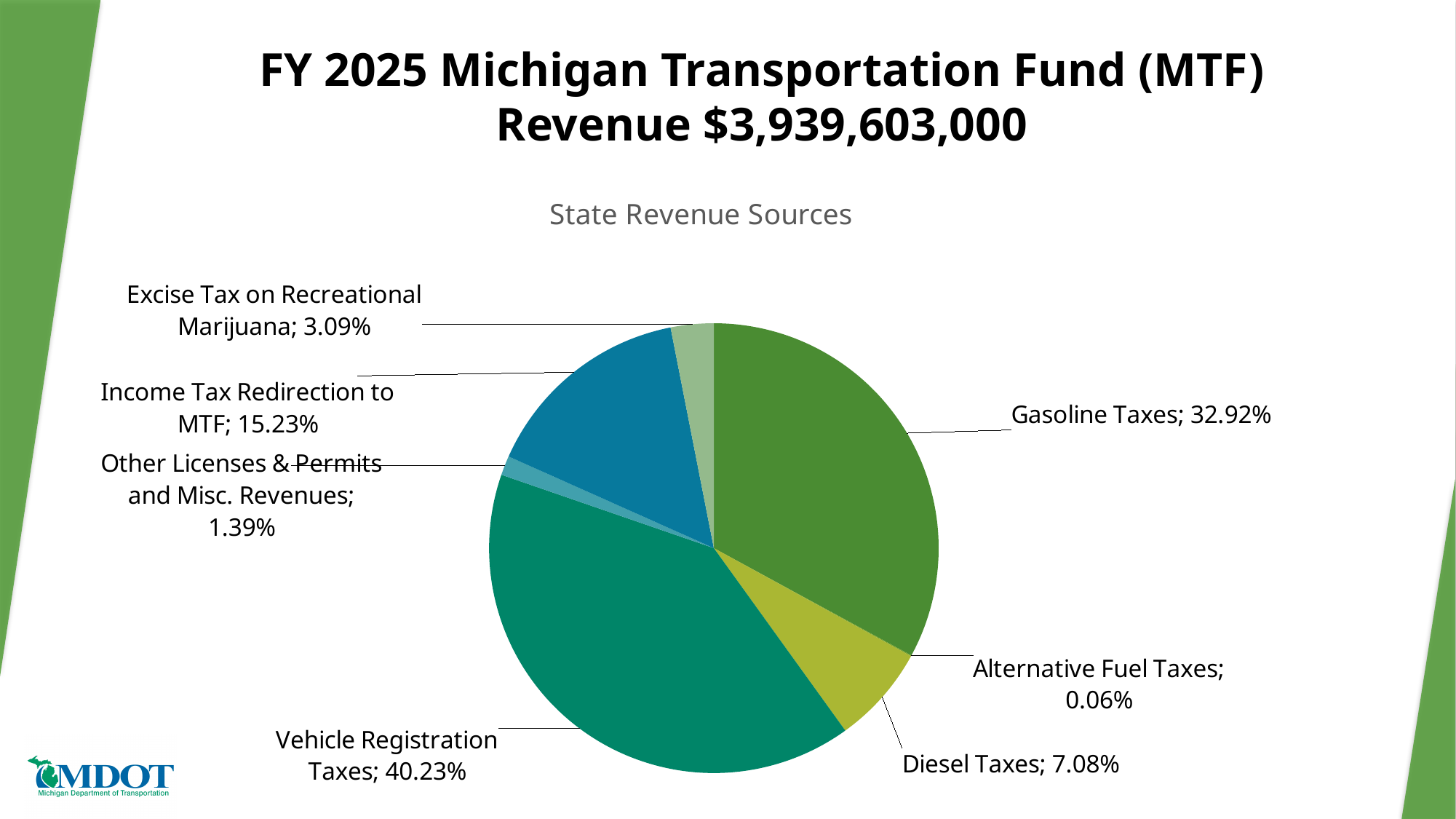
What percentage of the pie is Vehicle Registration Taxes? 40.23% Which is larger: Diesel Taxes or Excise Tax on Recreational Marijuana? Diesel Taxes How many revenue sources are shown in the pie chart? 7 What type of chart is shown on the slide? Pie chart What is the title of the chart? State Revenue Sources What is the share for Income Tax Redirection to MTF? 15.23% What share is labelled for Excise Tax on Recreational Marijuana? 3.09% Which revenue source has the smallest slice of the pie? Alternative Fuel Taxes What share of State Revenue Sources comes from Gasoline Taxes? 32.92% What percentage is shown for Diesel Taxes? 7.08% What is the difference in percentage points between Vehicle Registration Taxes and Gasoline Taxes? 7.31 Which revenue source has the largest slice of the pie? Vehicle Registration Taxes